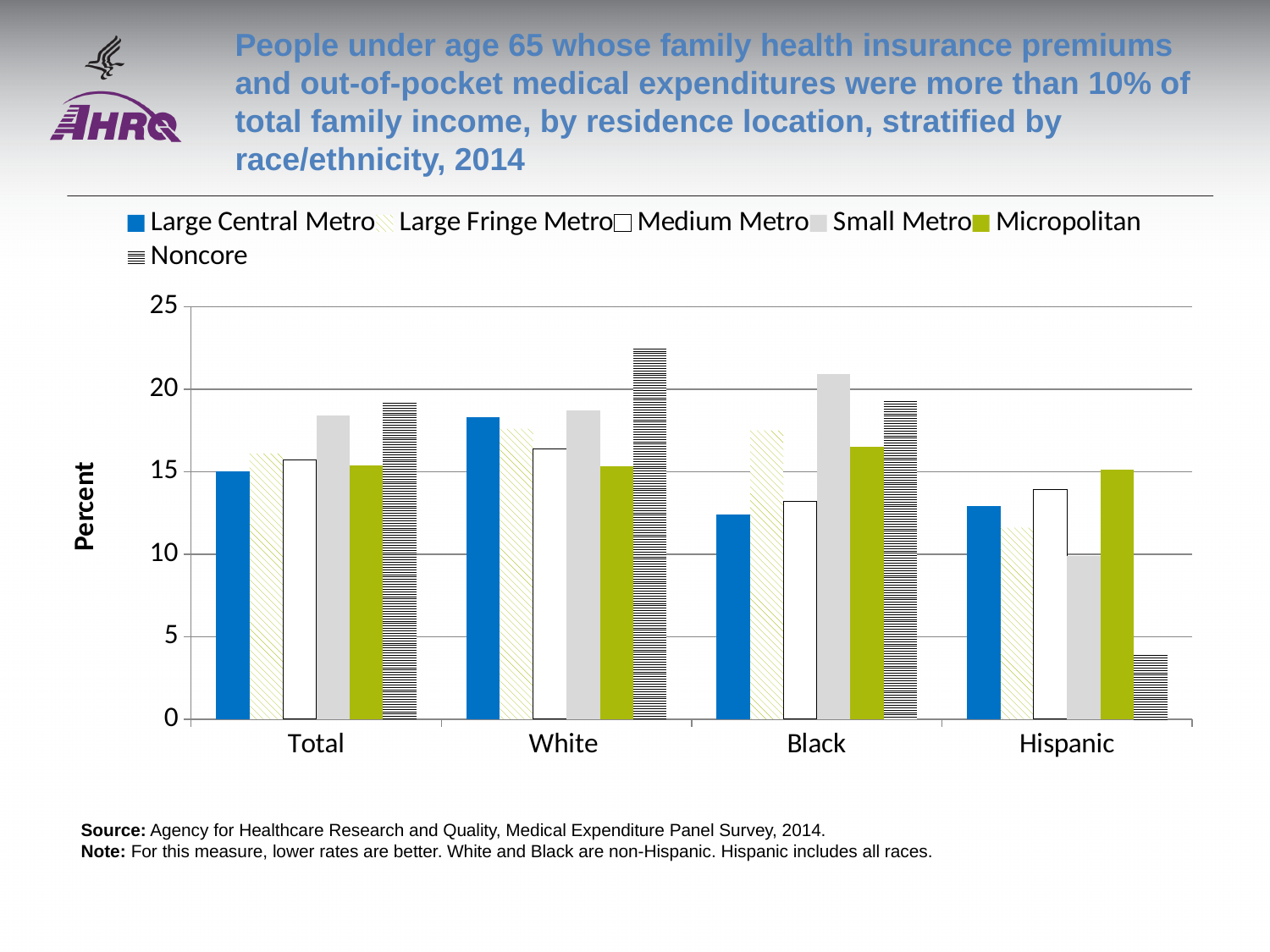
Is the value for Small Metro in the Black group greater or less than 20? greater What kind of chart is shown on the slide? bar chart In the Black group, which is larger: Small Metro or Large Central Metro? Small Metro Within the Hispanic group, which residence location has the highest value? Micropolitan Within the Hispanic group, which residence location has the lowest value? Noncore Within the White group, which residence location has the highest value? Noncore Is the value for Noncore in the Hispanic group greater or less than 5? less How many race/ethnicity categories are shown on the x axis? 4 Is the value for Noncore in the White group greater or less than 20? greater What is the label on the y axis? Percent How many series does the legend list? 6